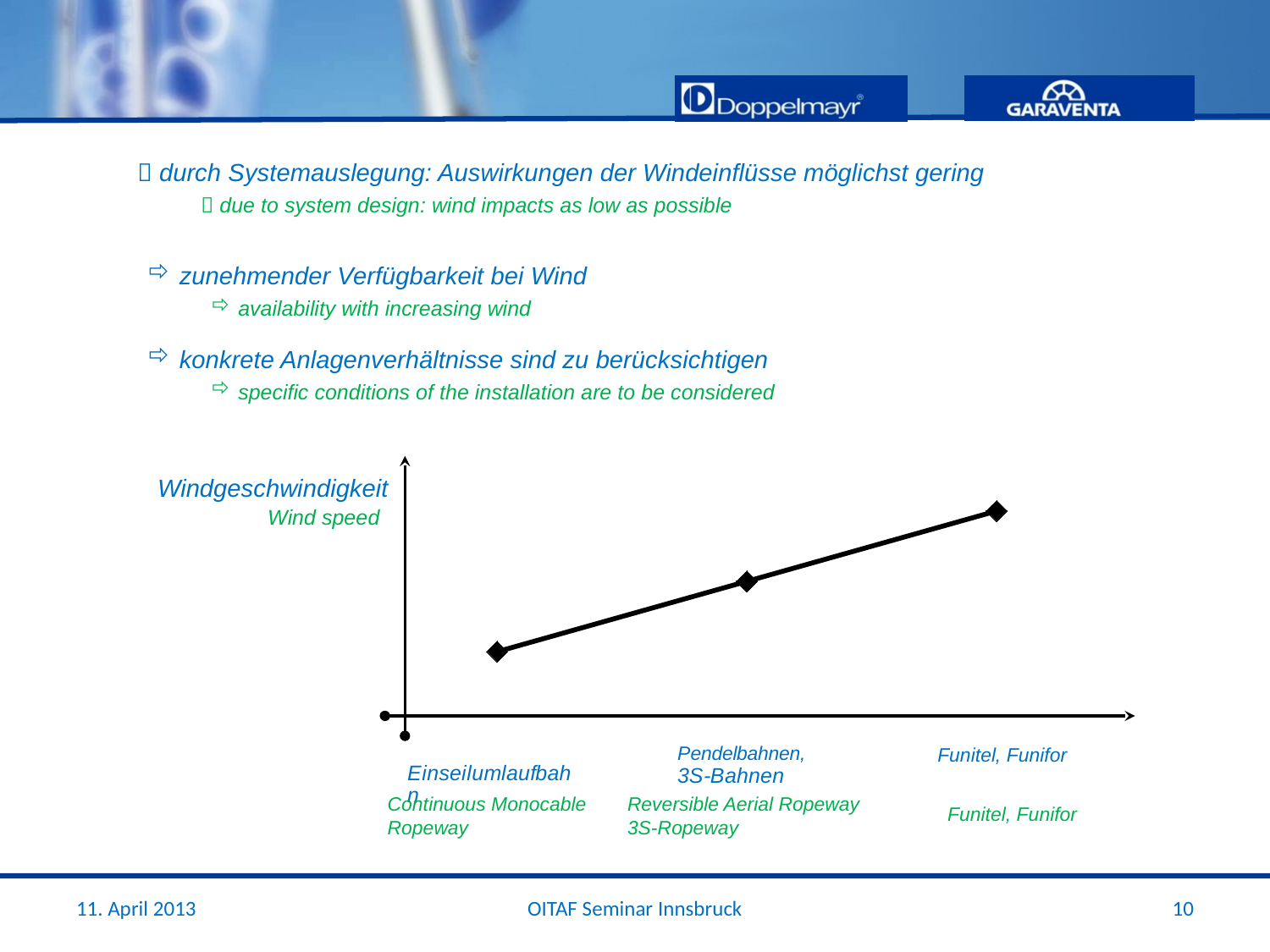
Which has the higher wind speed value: Pendelbahnen/3S-Bahnen or Einseilumlaufbahn? Pendelbahnen, 3S-Bahnen Which has the higher wind speed value: Funitel, Funifor or Pendelbahnen/3S-Bahnen? Funitel, Funifor What kind of chart is shown on the slide? line chart How many data points are plotted on the line in the chart? 3 What is the English label given for the middle category on the x axis? Reversible Aerial Ropeway, 3S-Ropeway What quantity is labelled on the vertical axis of the chart? Windgeschwindigkeit / Wind speed Do the plotted values rise or fall from left to right along the x axis? rise Which ropeway system has the lowest wind speed value in the chart? Einseilumlaufbahn (Continuous Monocable Ropeway) Which ropeway system has the highest wind speed value in the chart? Funitel, Funifor